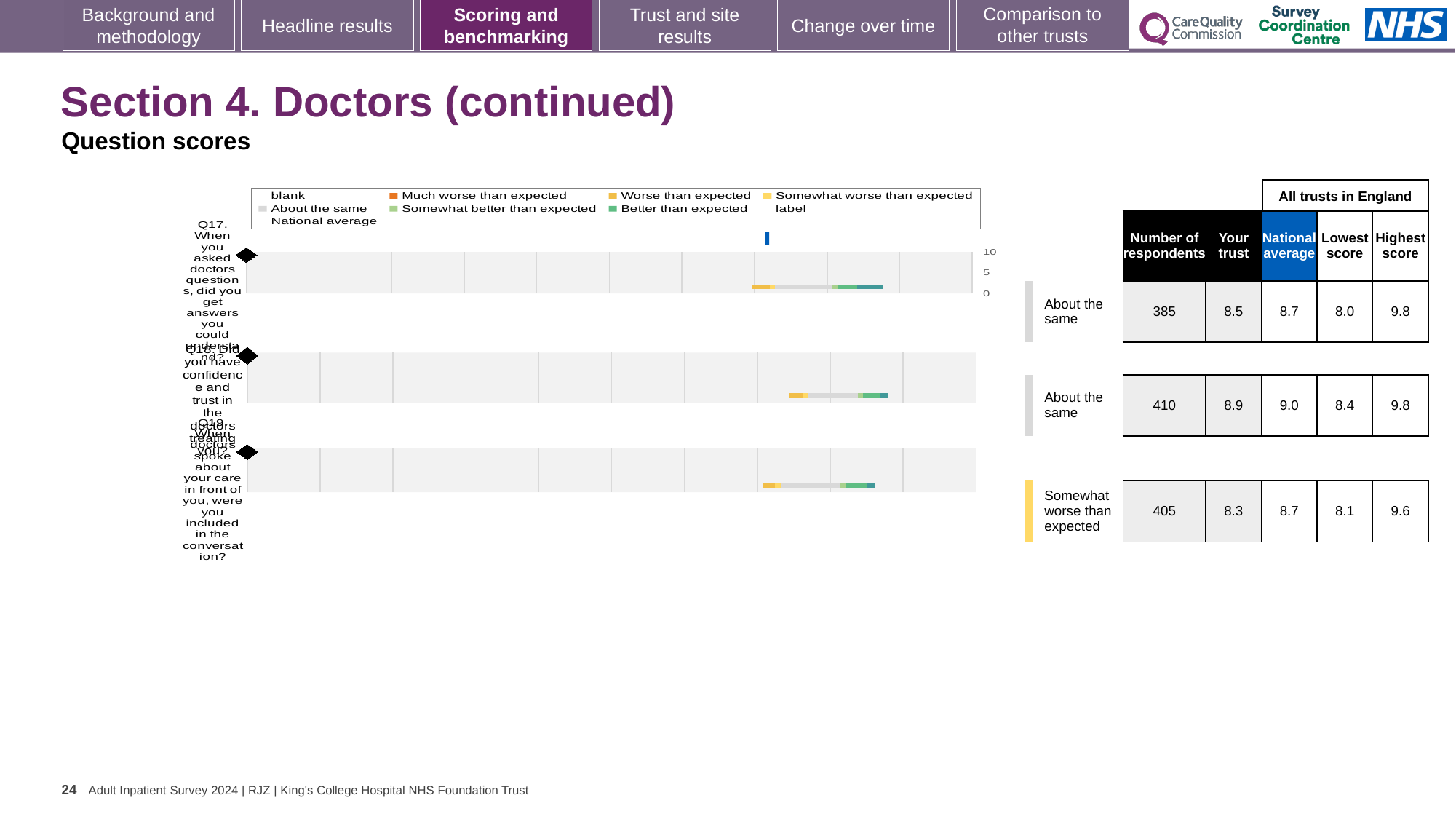
What kind of chart is shown on the slide? bar chart For Q19, what is the difference between the highest score and the lowest score in the table? 1.5 How many questions (categories) are plotted in the chart? 3 What colour does the legend use for 'Much worse than expected'? orange Which question has the highest 'Your trust' score in the table? Q18 How many entries does the chart legend list? 9 In the table beside the chart, how many respondents are listed for Q19? 405 What is the highest tick value shown on the chart's score axis? 10 Which question is rated 'Somewhat worse than expected'? Q19 In the table beside the chart, what is the 'Your trust' score for Q17? 8.5 For Q18, which is larger: the 'Your trust' score or the national average? national average In the table beside the chart, what is the national average for Q18? 9.0